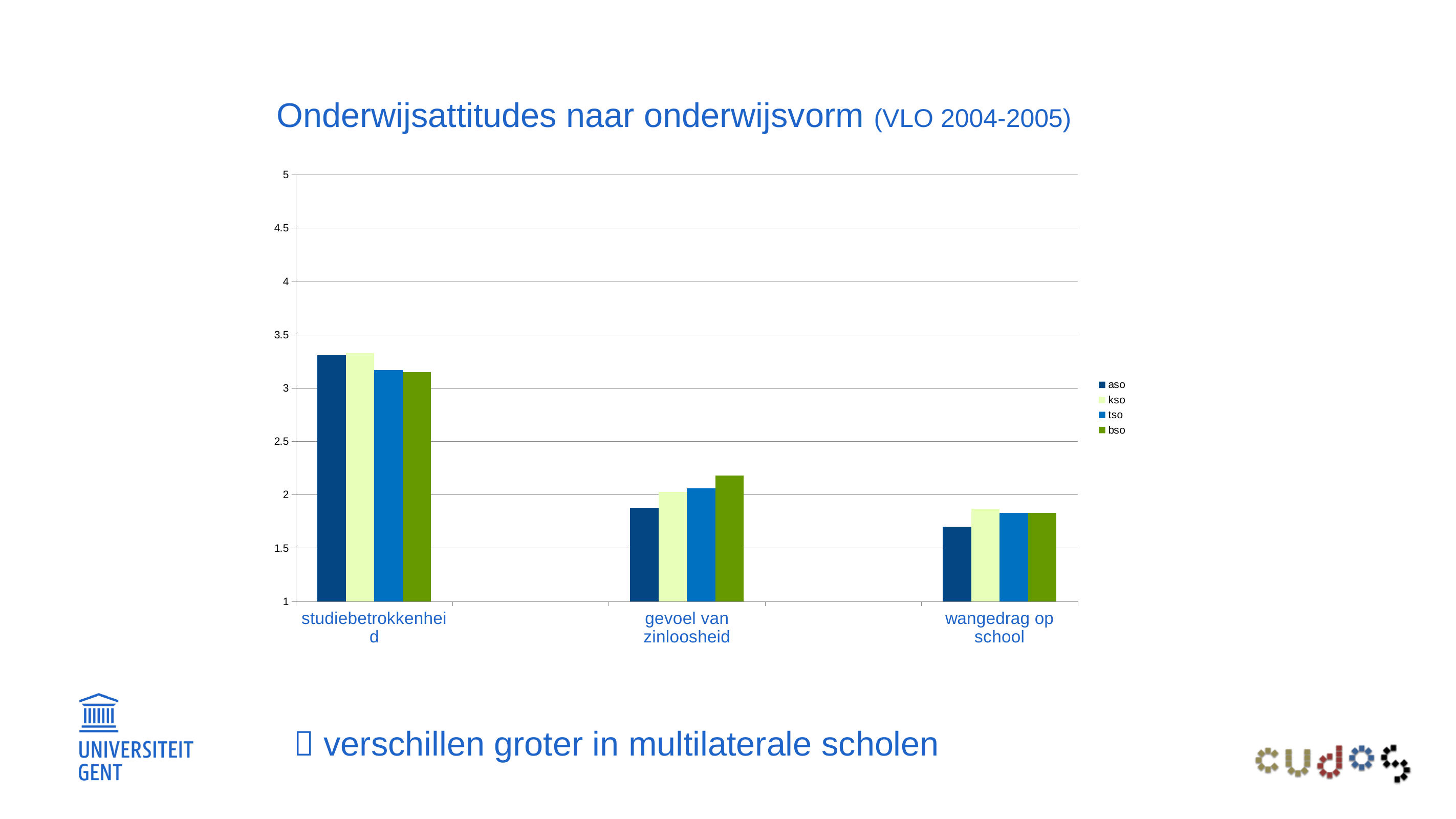
Which series are listed in the chart's legend? aso, kso, tso, bso Is the value for bso in the gevoel van zinloosheid category greater or less than 2? greater Which series has the highest value in the gevoel van zinloosheid category? bso How many series does the chart's legend list? 4 How many categories are shown on the x axis of the chart? 3 What is the title of the chart on the slide? Onderwijsattitudes naar onderwijsvorm (VLO 2004-2005) Which series has the lowest value in the wangedrag op school category? aso Is the value for aso in the studiebetrokkenheid category greater or less than 3? greater What kind of chart is shown on the slide? bar chart Is the value for aso in the wangedrag op school category greater or less than 2? less In the studiebetrokkenheid category, which is larger: the value for aso or the value for tso? aso